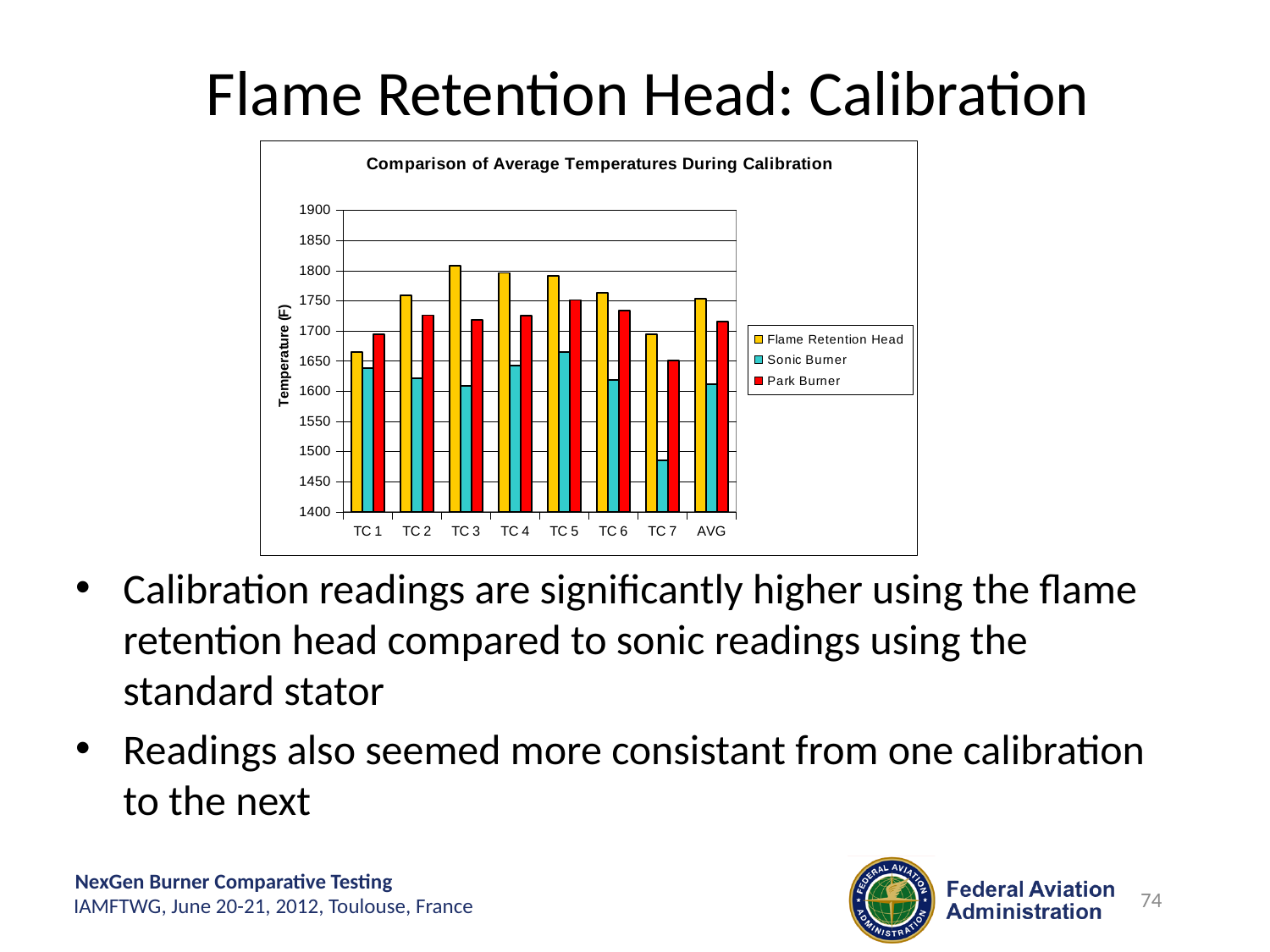
Is the Sonic Burner value for TC 7 greater or less than 1500? less Is the Park Burner value for TC 5 greater or less than 1700? greater Which category has the lowest Flame Retention Head value? TC 1 What is the title of the chart? Comparison of Average Temperatures During Calibration For TC 7, which is larger: the Flame Retention Head value or the Park Burner value? Flame Retention Head What is the label on the vertical axis of the chart? Temperature (F) How many series does the chart legend list? 3 What kind of chart is shown on the slide? Bar chart Which category has the highest Flame Retention Head value? TC 3 Is the Flame Retention Head value for TC 3 greater or less than 1800? greater Which category has the lowest Sonic Burner value? TC 7 How many categories are shown along the x axis of the chart? 8